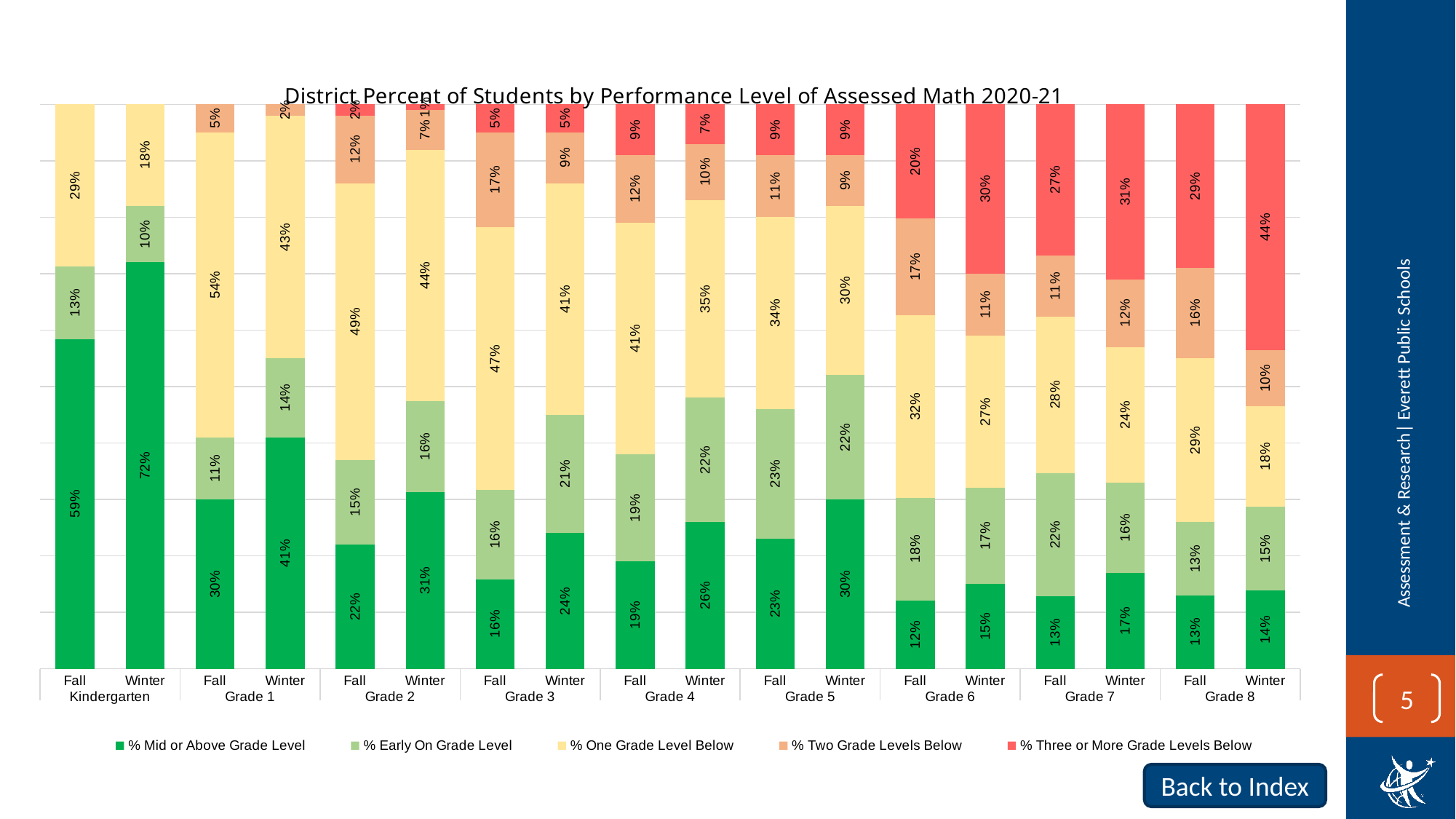
What is the title of the chart? District Percent of Students by Performance Level of Assessed Math 2020-21 What is the % One Grade Level Below value for Grade 1 Fall? 54% How many bars are plotted in the chart? 18 What is the difference between the % Mid or Above Grade Level values for Grade 2 Winter and Grade 2 Fall? 9% Which bar has the lowest % Mid or Above Grade Level value? Grade 6 Fall Does the % Three or More Grade Levels Below value generally rise or fall from Grade 2 Fall to Grade 8 Winter? Rise How many series does the legend list? 5 What is the % Mid or Above Grade Level value for Kindergarten Winter? 72% What is the % Three or More Grade Levels Below value for Grade 8 Winter? 44% What type of chart is shown on the slide? Stacked bar chart Which bar has the highest % Mid or Above Grade Level value? Kindergarten Winter Which is larger: the % Three or More Grade Levels Below value for Grade 6 Winter or for Grade 7 Fall? Grade 6 Winter